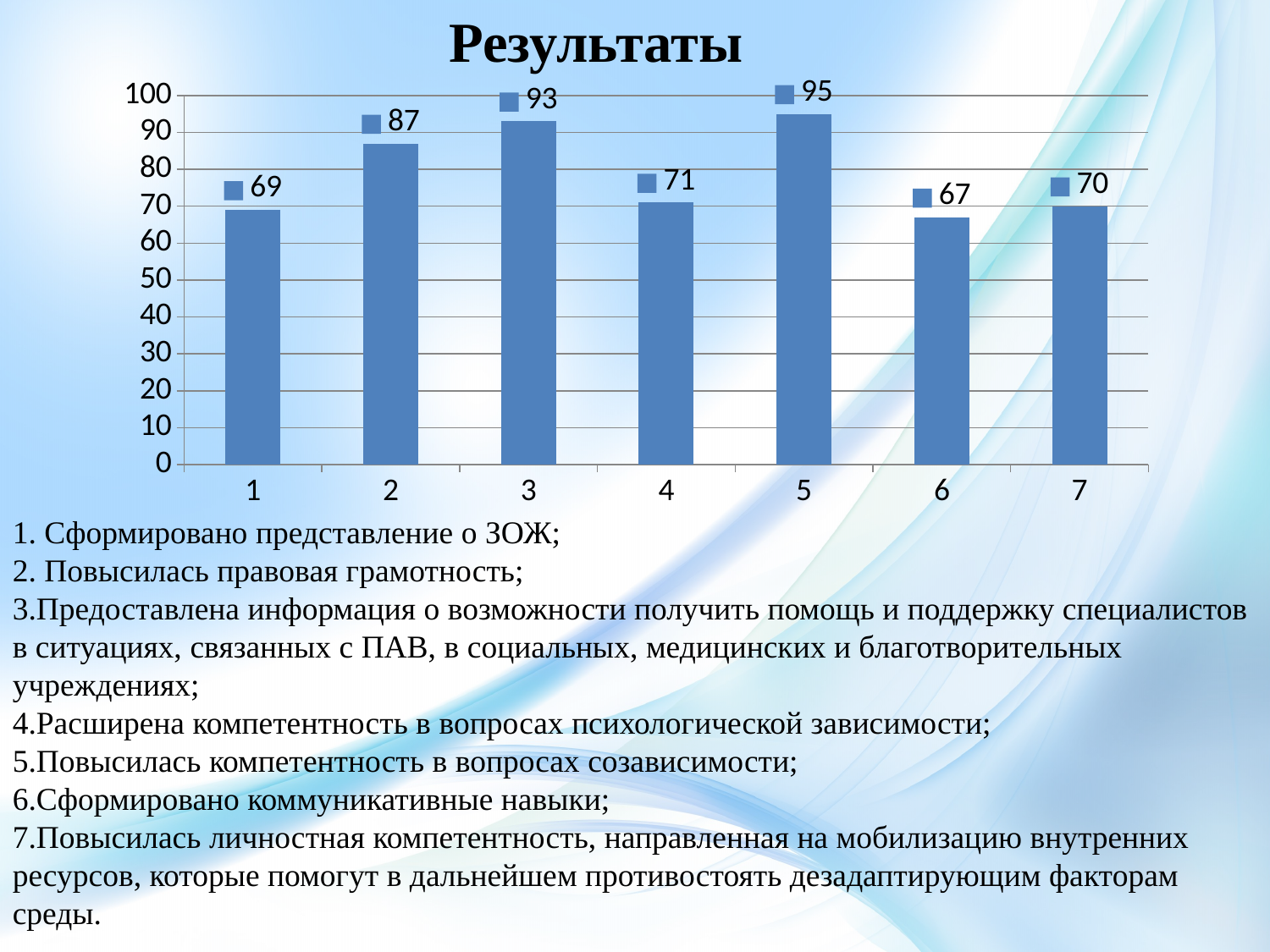
Which category has the lowest value? 6 What is the title of the slide above the chart? Результаты What is the value for category 6? 67 What is the value for category 1? 69 What is the difference between the values for category 2 and category 1? 18 What kind of chart is shown on the slide? bar chart Is the value for category 2 greater or less than 80? greater What is the value for category 3? 93 What is the difference between the values for category 5 and category 6? 28 Which category has the highest value? 5 How many categories are shown on the x axis? 7 Which is larger, the value for category 4 or the value for category 7? category 4